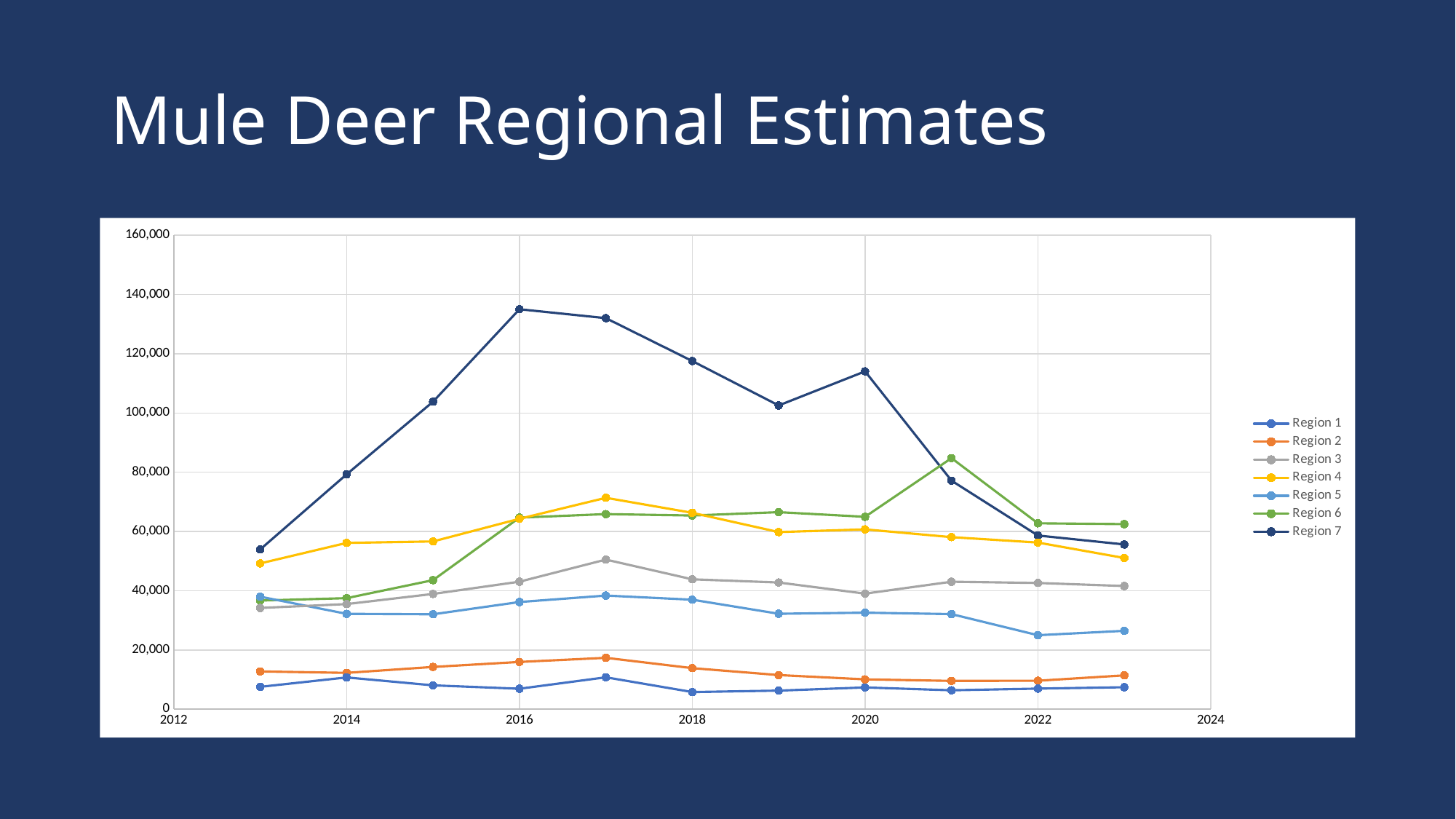
What kind of chart is shown on the slide? line chart How many series does the legend list? 7 Is the value for Region 7 in 2013 greater or less than 60,000? less Is the value for Region 5 in 2022 greater or less than 20,000? greater In 2021, which is larger: Region 6 or Region 7? Region 6 Does the value for Region 7 rise or fall from 2013 to 2016? rise In 2013, which is larger: Region 4 or Region 3? Region 4 Is the value for Region 7 in 2016 greater or less than 120,000? greater Which region has the highest value in 2016? Region 7 How many years are plotted for each region? 11 Which region has the lowest value in 2023? Region 1